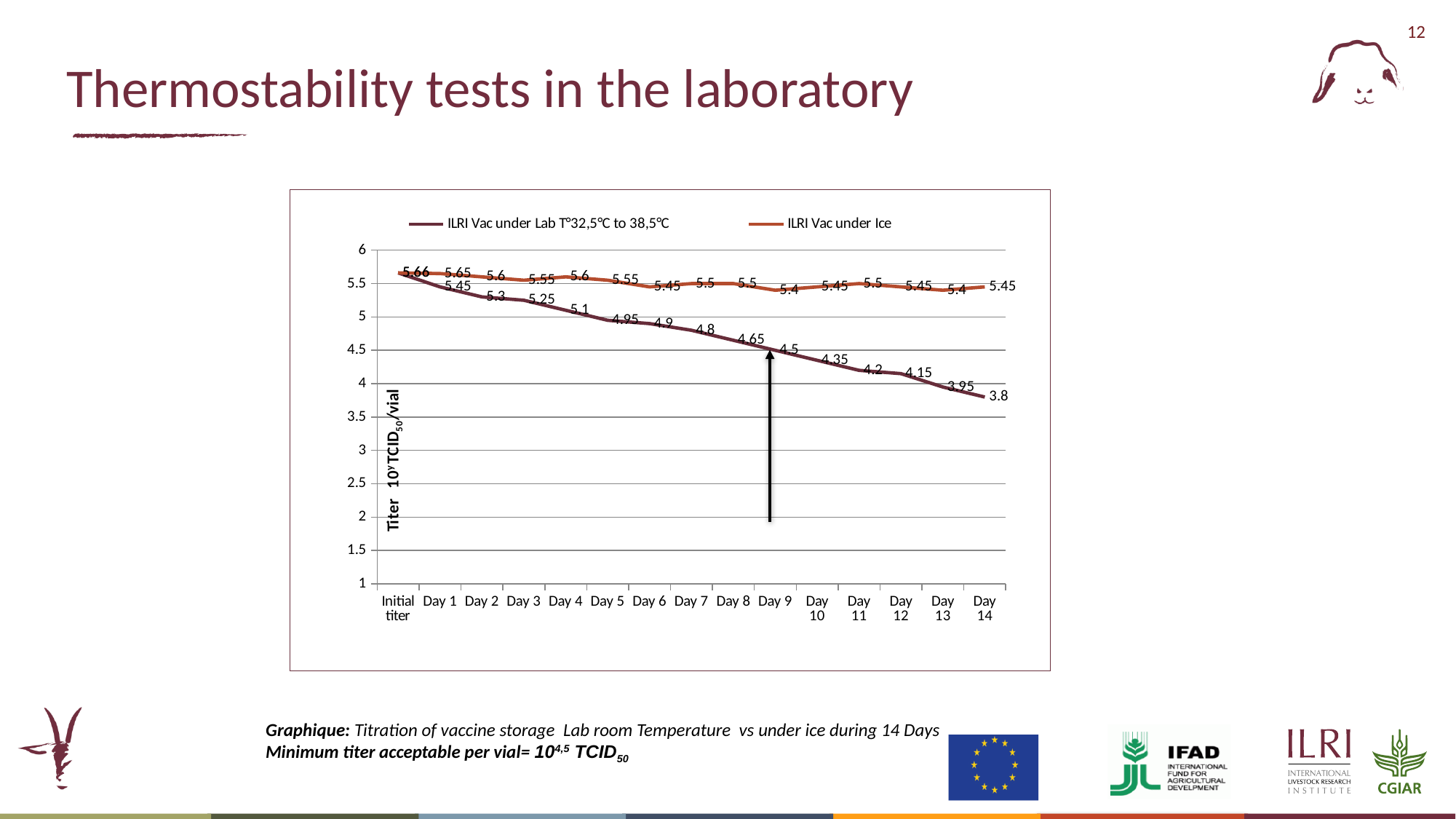
Does the ILRI Vac under Lab T°32,5℃ to 38,5℃ series rise or fall from the initial titer to Day 14? Fall On which day does the ILRI Vac under Lab T°32,5℃ to 38,5℃ series reach its lowest value? Day 14 How many time points are plotted along the x axis? 15 How many series does the chart legend list? 2 Which series has the higher value on Day 10? ILRI Vac under Ice What is the difference between the ILRI Vac under Ice and ILRI Vac under Lab T°32,5℃ to 38,5℃ values on Day 14? 1.65 What is the titer value for ILRI Vac under Ice on Day 14? 5.45 What is the titer value for ILRI Vac under Lab T°32,5℃ to 38,5℃ on Day 14? 3.8 What is the titer value for ILRI Vac under Lab T°32,5℃ to 38,5℃ on Day 9? 4.5 What is the titer value for ILRI Vac under Ice on Day 9? 5.4 What is the y-axis label of the chart? Titer 10^Y TCID50/vial What type of chart is shown on the slide? Line chart